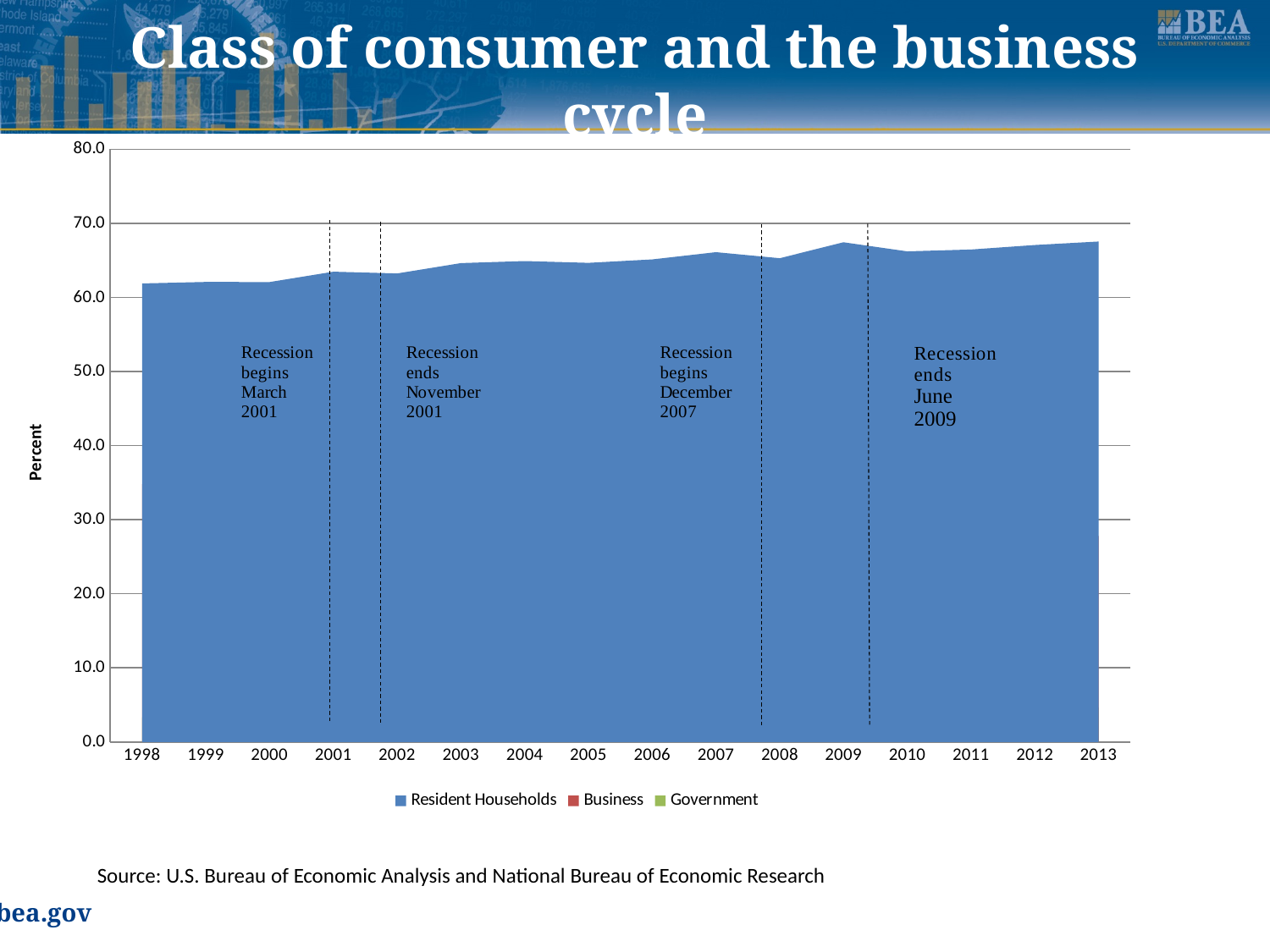
How many years are shown along the x axis? 16 How many series does the legend list? 3 Is the value for Resident Households in 2013 greater or less than 70? less Which is larger, the Resident Households value in 1998 or in 2013? 2013 Is the value for Resident Households in 2007 greater or less than 60? greater What is the label on the y axis of the chart? Percent What is the title of the chart on the slide? Class of consumer and the business cycle Which is larger, the Resident Households value in 2001 or in 2007? 2007 What kind of chart is shown on the slide? Area chart Does the Resident Households share generally rise or fall from 1998 to 2013? rise What is the first year shown on the x axis? 1998 Is the value for Resident Households in 1998 greater or less than 60? greater